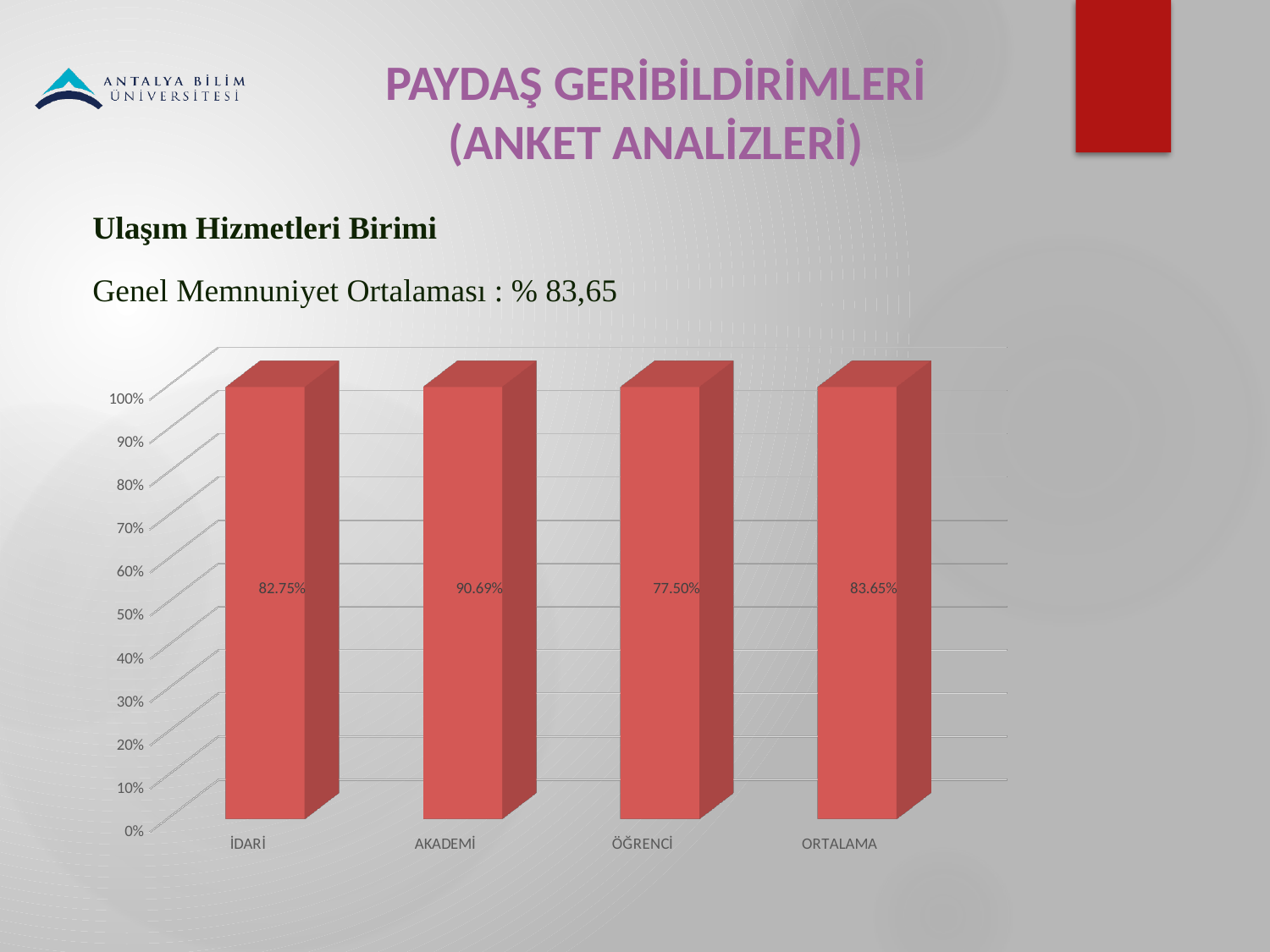
Which is larger, the value for İDARİ or the value for ORTALAMA? ORTALAMA How many categories are shown on the x axis? 4 What is the value for AKADEMİ? 90.69% Which category has the lowest value? ÖĞRENCİ What is the highest tick value shown on the vertical axis? 100% What is the difference between the values for AKADEMİ and ÖĞRENCİ? 13.19% What is the difference between the values for AKADEMİ and İDARİ? 7.94% What is the value for ÖĞRENCİ? 77.50% Which category has the highest value? AKADEMİ What kind of chart is shown on the slide? Bar chart What is the value for İDARİ? 82.75% What is the value for ORTALAMA? 83.65%